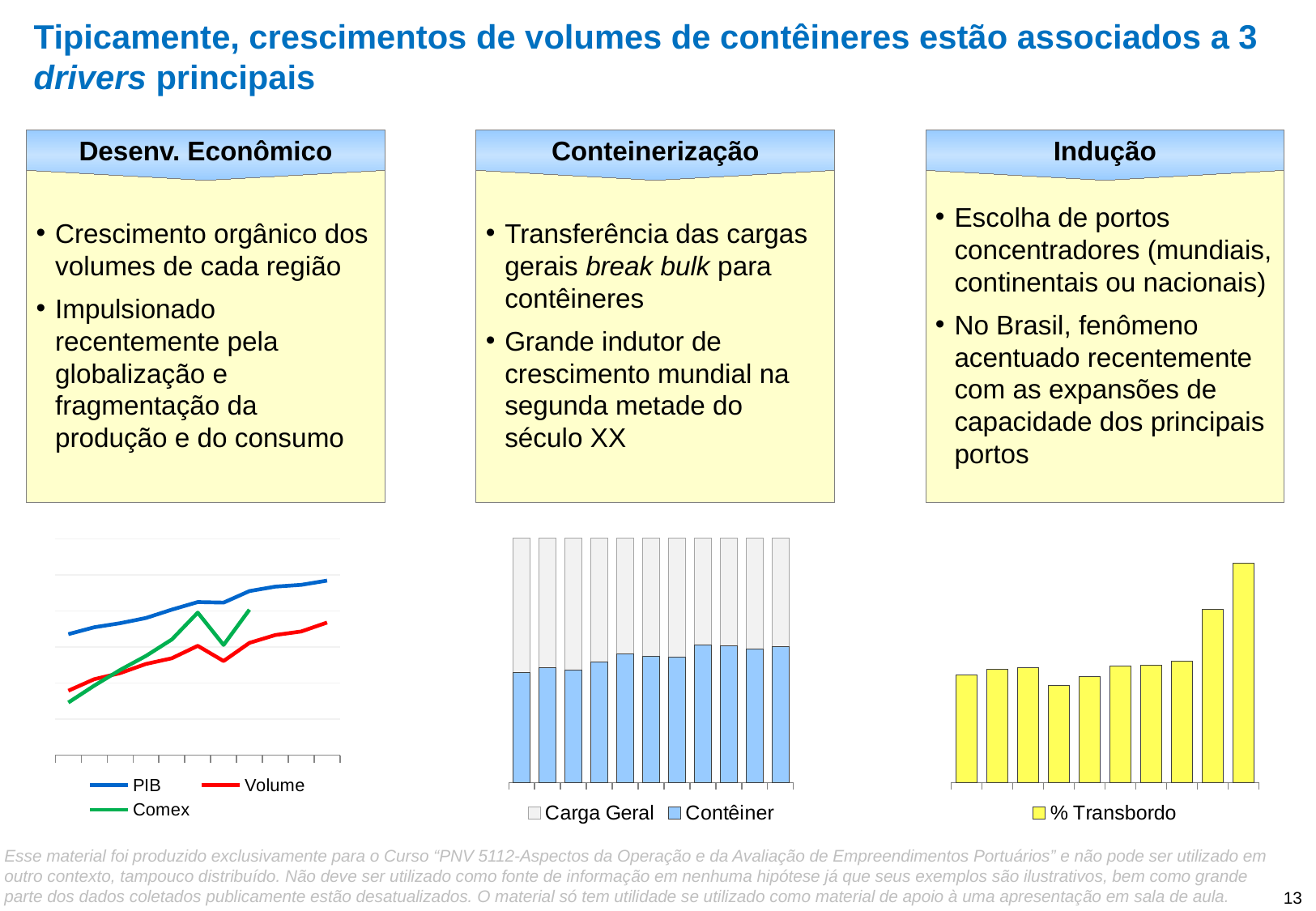
How many bars are there in the bottom-middle stacked bar chart? 11 How many series does the legend of the bottom-right bar chart list? 1 What are the names of the series in the legend of the bottom-left line chart? PIB, Volume, Comex What kind of chart is the chart under the 'Conteinerização' box (bottom middle)? stacked bar chart What kind of chart is the chart under the 'Indução' box (bottom right)? bar chart How many bars are there in the bottom-right '% Transbordo' bar chart? 10 In the bottom-middle stacked bar chart, does the Contêiner portion of the bars generally rise or fall from left to right? rise In the bottom-left line chart, does the PIB line rise or fall from left to right? rise What kind of chart is the chart under the 'Desenv. Econômico' box (bottom left)? line chart How many series does the legend of the bottom-left line chart list? 3 What colour are the bars in the bottom-right '% Transbordo' chart? yellow How many series does the legend of the bottom-middle stacked bar chart list? 2